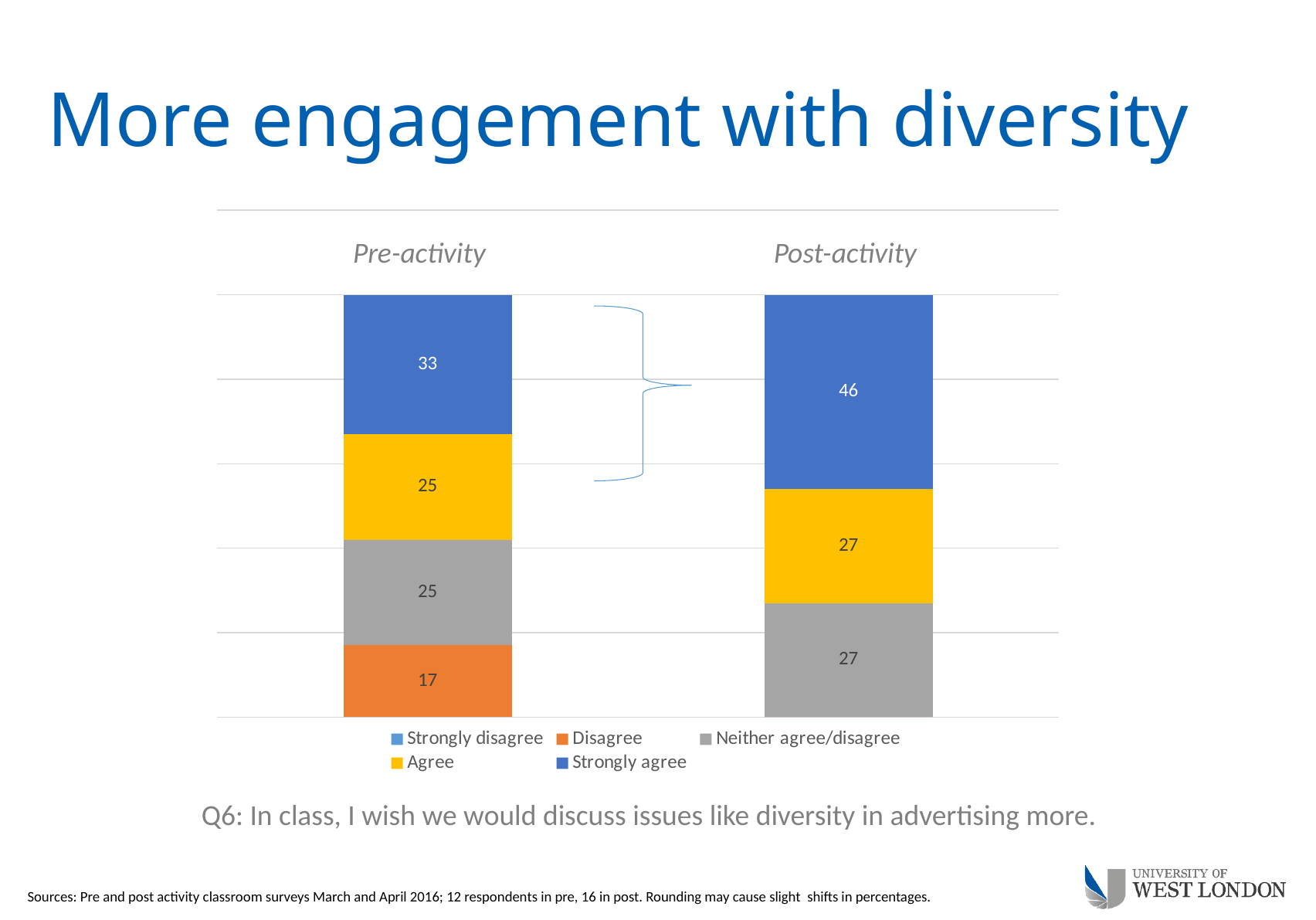
What is the difference between the Agree values for Post-activity and Pre-activity? 2 How many bars are plotted in the chart? 2 What is the Strongly agree value for the Post-activity bar? 46 What is the Agree value for the Pre-activity bar? 25 Which segment is the smallest in the Pre-activity bar? Disagree Which bar has the larger Strongly agree segment, Pre-activity or Post-activity? Post-activity How many series does the legend list? 5 What is the Neither agree/disagree value for the Post-activity bar? 27 What kind of chart is shown on the slide? Stacked bar chart What is the Disagree value for the Pre-activity bar? 17 What is the difference between the Strongly agree values for Post-activity and Pre-activity? 13 Which segment is the largest in the Post-activity bar? Strongly agree